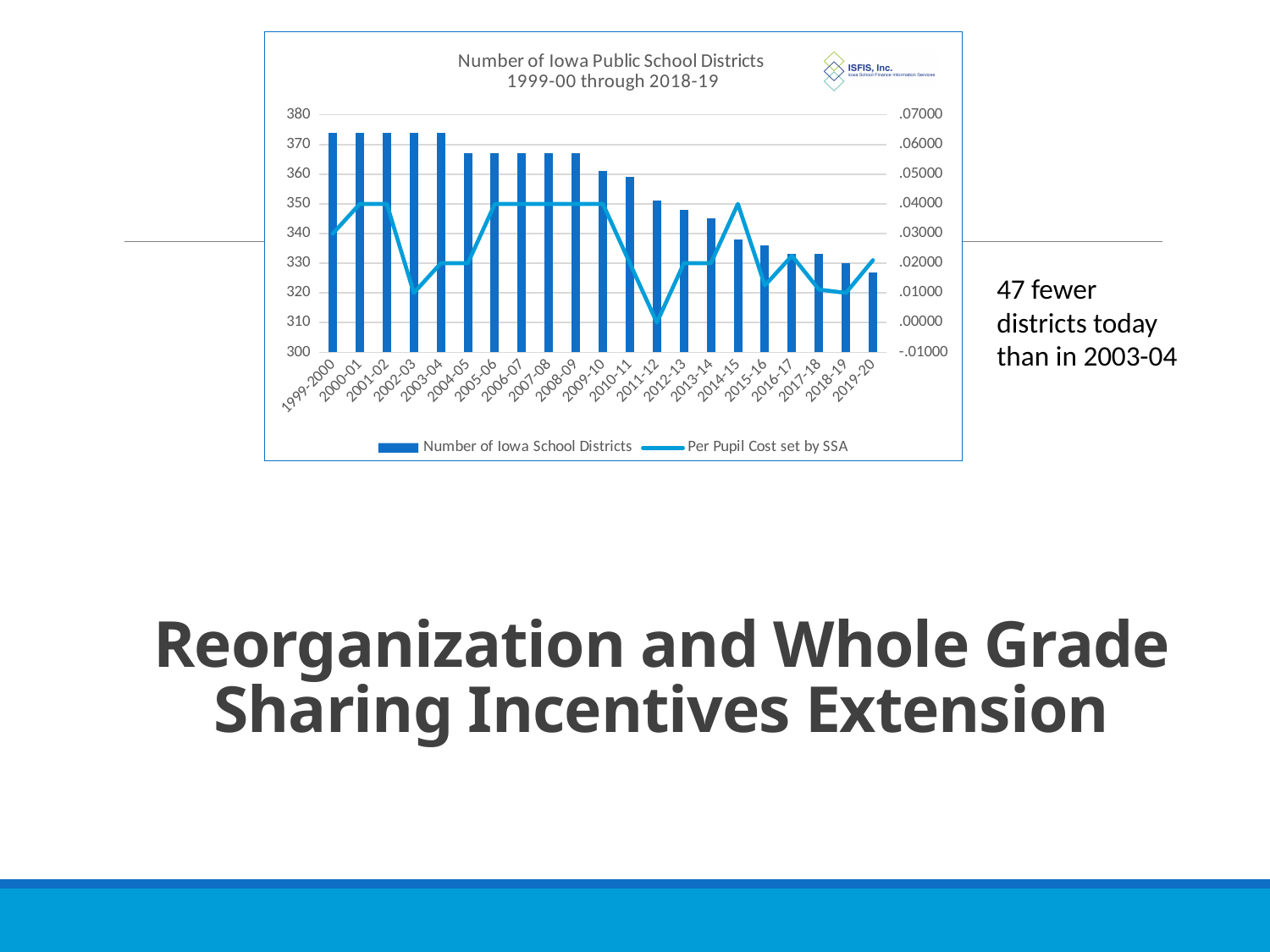
Is the Number of Iowa School Districts for 1999-2000 greater or less than 370? greater Is the Number of Iowa School Districts for 2009-10 greater or less than 350? greater Do the bars for Number of Iowa School Districts generally rise or fall from 1999-2000 to 2019-20? Fall Which school year has the lowest Per Pupil Cost set by SSA? 2011-12 Is the Number of Iowa School Districts for 2019-20 greater or less than 340? less What kind of chart is shown on the slide? A combination bar and line chart How many series does the legend list? 2 How many school years are shown on the x axis? 21 Which is larger, the Number of Iowa School Districts in 2004-05 or in 2014-15? 2004-05 What is the title of the chart? Number of Iowa Public School Districts 1999-00 through 2018-19